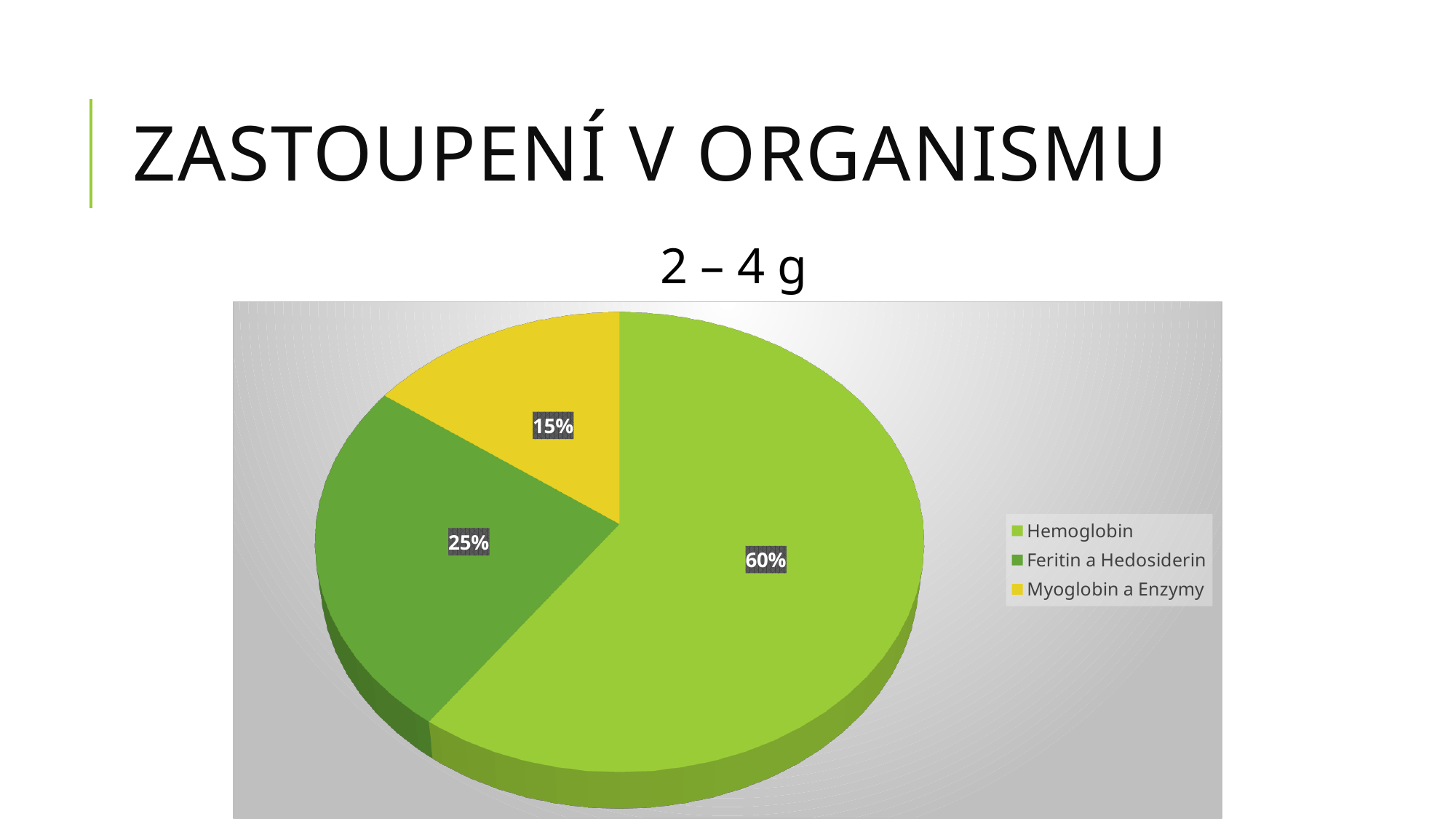
What is the difference between the Hemoglobin share and the Feritin a Hedosiderin share? 35% What share of the pie does Feritin a Hedosiderin represent? 25% Which category has the smallest slice of the pie? Myoglobin a Enzymy How many slices does the pie chart have? 3 Which category has the largest slice of the pie? Hemoglobin What colour is the Myoglobin a Enzymy slice? yellow What share of the pie does Myoglobin a Enzymy represent? 15% What is the title of the chart? 2 – 4 g What is the difference between the Feritin a Hedosiderin share and the Myoglobin a Enzymy share? 10% What kind of chart is shown on the slide? pie chart Which is larger, the share for Feritin a Hedosiderin or the share for Myoglobin a Enzymy? Feritin a Hedosiderin What share of the pie does Hemoglobin represent? 60%